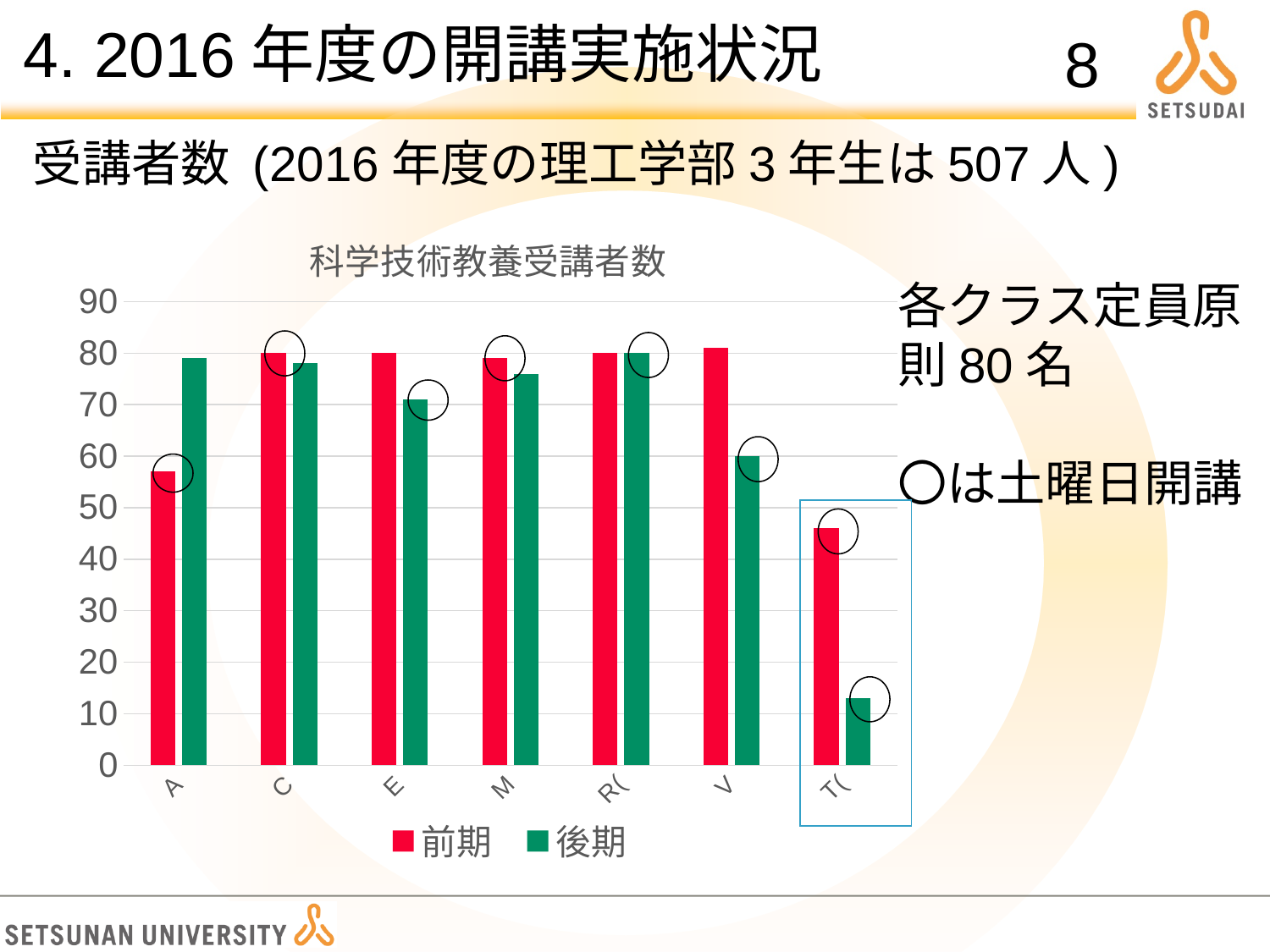
Is the 後期 value for category V greater or less than 70? less What are the two series named in the chart legend? 前期 and 後期 Is the 後期 value for category E greater or less than 80? less Is the 前期 value for category A greater or less than 60? less How many categories are plotted along the x axis of the chart? 7 How many series does the legend of the chart list? 2 For category V, which series has the larger value, 前期 or 後期? 前期 What kind of chart is shown on the slide? bar chart What is the title of the chart? 科学技術教養受講者数 For category A, which series has the larger value, 前期 or 後期? 後期